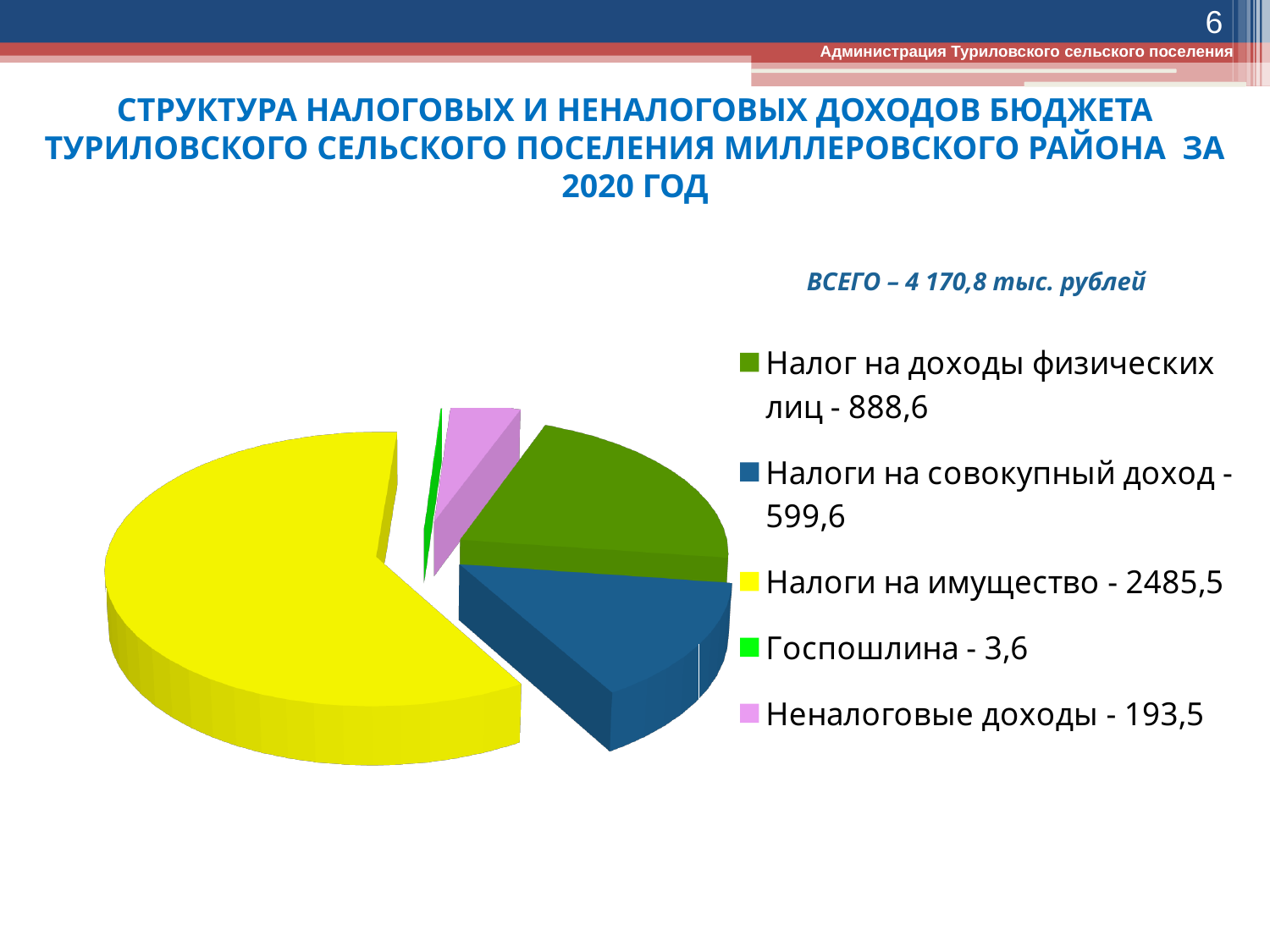
Which category has the smallest slice of the pie chart? Госпошлина What is the value for Налог на доходы физических лиц? 888,6 How many categories does the pie chart show? 5 Which is larger: Налоги на совокупный доход or Неналоговые доходы? Налоги на совокупный доход What is the difference between Налог на доходы физических лиц and Налоги на совокупный доход? 289,0 What is the difference between Налоги на имущество and Налог на доходы физических лиц? 1596,9 What kind of chart is shown on the slide? Pie chart What is the value for Неналоговые доходы? 193,5 What total amount (ВСЕГО) is stated on the slide? 4 170,8 тыс. рублей What is the value for Госпошлина? 3,6 What is the value for Налоги на имущество in the pie chart? 2485,5 Which category has the largest slice of the pie chart? Налоги на имущество